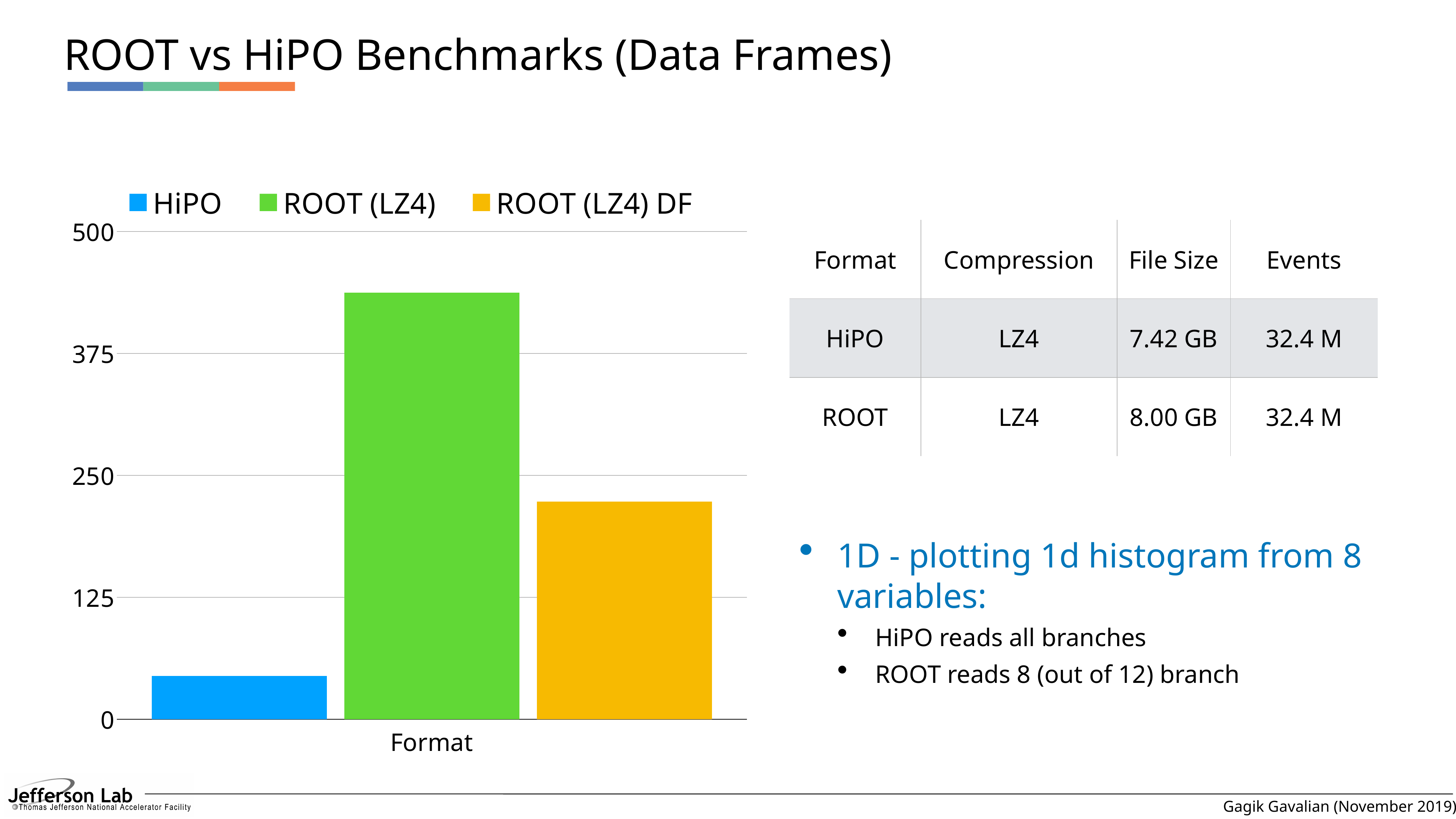
Is the value for HiPO greater or less than 125? less What colour is the bar for the HiPO series? blue What is the label on the x axis of the chart? Format How many series does the chart legend list? 3 Is the value for ROOT (LZ4) DF greater or less than 125? greater Which series has the highest bar in the chart? ROOT (LZ4) Is the value for ROOT (LZ4) greater or less than 375? greater Which is larger, the bar for HiPO or the bar for ROOT (LZ4) DF? ROOT (LZ4) DF Which is larger, the bar for ROOT (LZ4) or the bar for ROOT (LZ4) DF? ROOT (LZ4) What kind of chart is shown on the slide? bar chart Which series has the lowest bar in the chart? HiPO